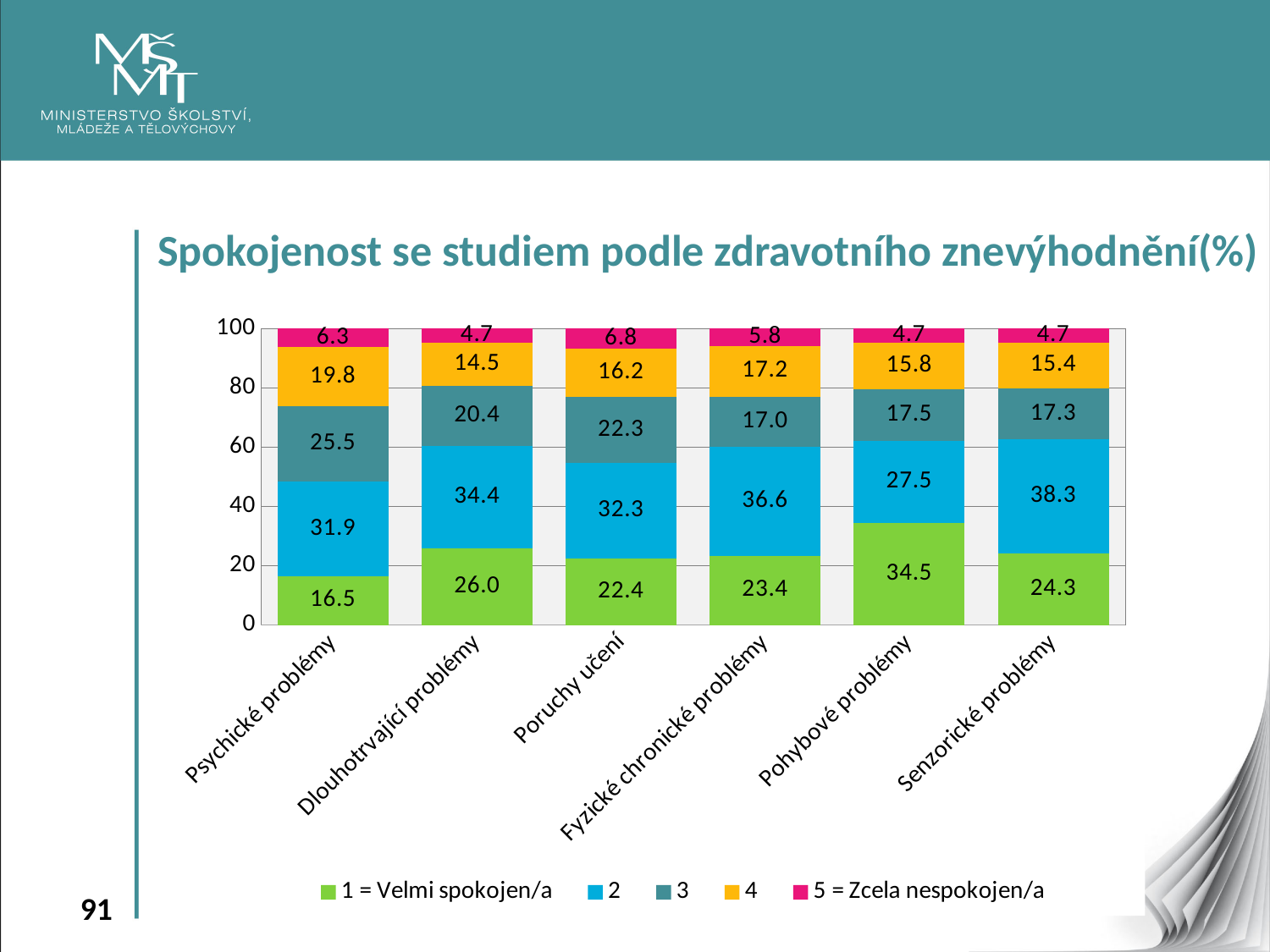
How many categories are shown on the x axis? 6 Which category has the highest value for "1 = Velmi spokojen/a"? Pohybové problémy What is the value of series "5 = Zcela nespokojen/a" for Poruchy učení? 6.8 What is the total of the stacked bar for Dlouhotrvající problémy? 100.0 What is the value of series 2 for Senzorické problémy? 38.3 Which category has the lowest value for "1 = Velmi spokojen/a"? Psychické problémy What is the difference between the series 2 values for Fyzické chronické problémy and Pohybové problémy? 9.1 How many series does the legend list? 5 What is the value for "1 = Velmi spokojen/a" in the Pohybové problémy bar? 34.5 What kind of chart is shown on the slide? Stacked bar chart What is the title of the chart? Spokojenost se studiem podle zdravotního znevýhodnění(%) Which is larger: the series 3 value for Psychické problémy or for Dlouhotrvající problémy? Psychické problémy